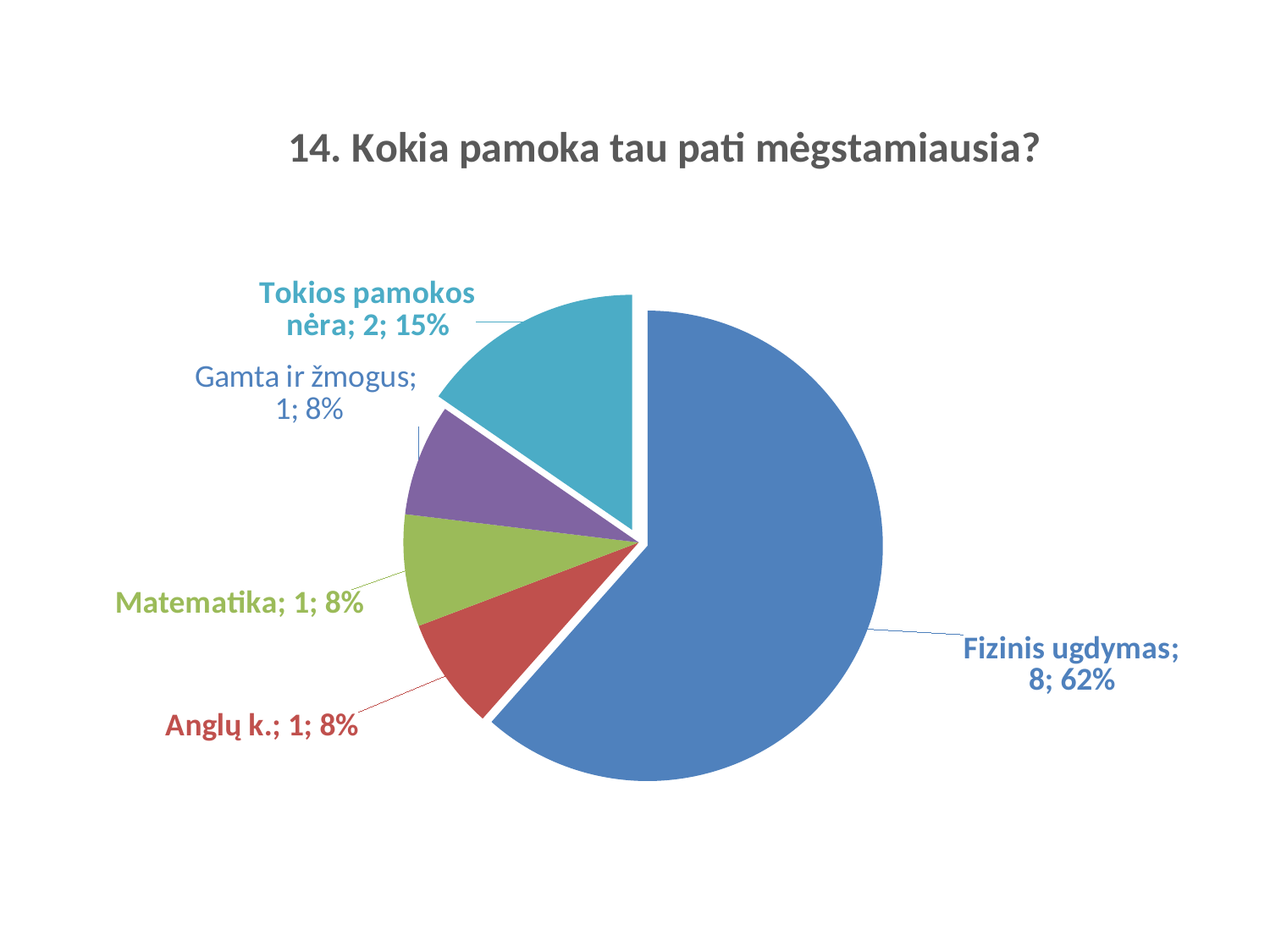
What percentage share does Tokios pamokos nėra have? 15% What is the count for Tokios pamokos nėra? 2 What colour is the Fizinis ugdymas slice? blue What is the difference in count between Fizinis ugdymas and Tokios pamokos nėra? 6 What is the count for Fizinis ugdymas? 8 Which is larger, the slice for Tokios pamokos nėra or the slice for Anglų k.? Tokios pamokos nėra What is the title of the chart? 14. Kokia pamoka tau pati mėgstamiausia? What percentage share does Matematika have? 8% What percentage share does Fizinis ugdymas have? 62% Which category has the largest slice? Fizinis ugdymas How many slices does the pie chart have? 5 What kind of chart is shown on the slide? pie chart